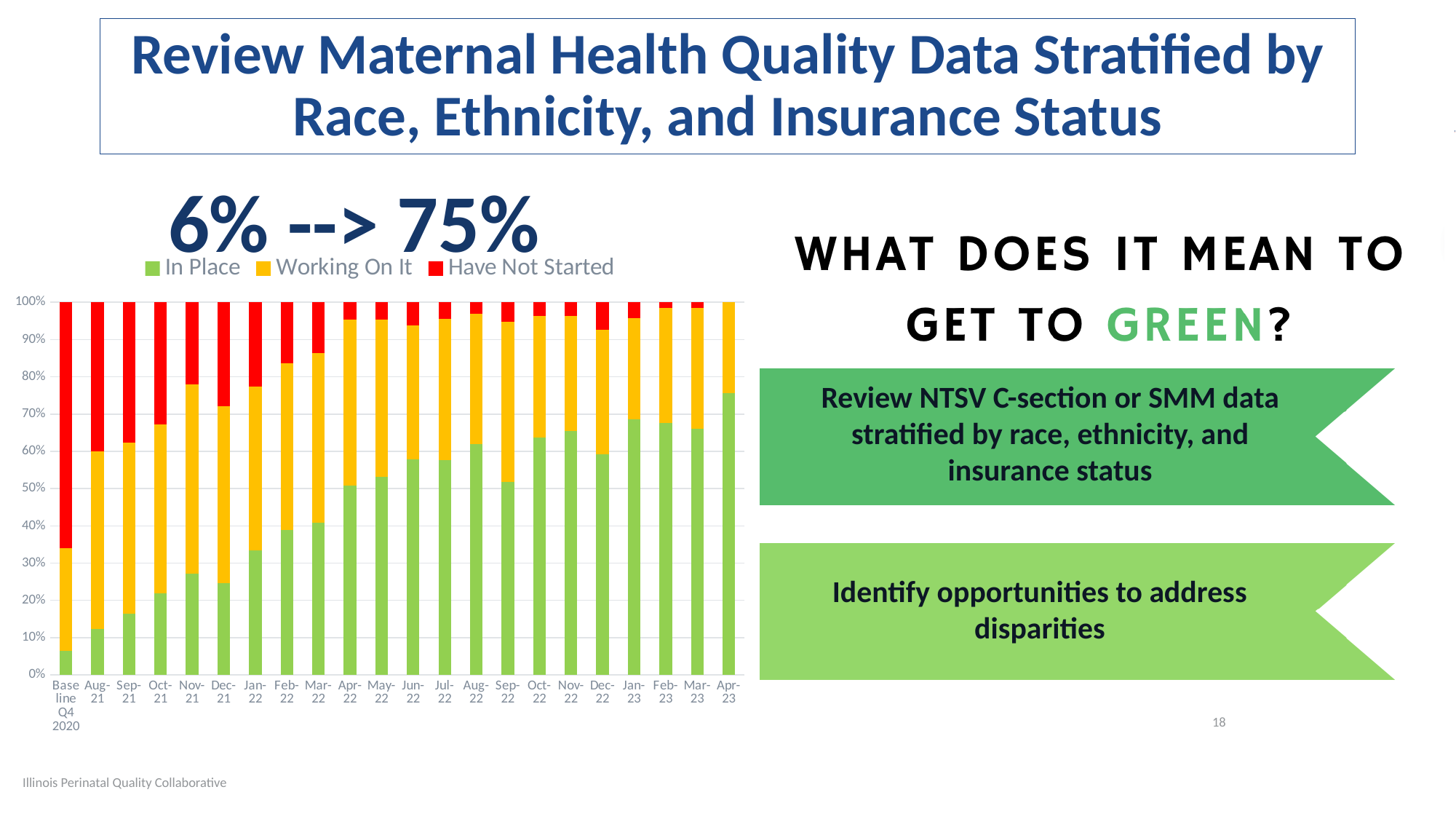
Is the 'In Place' value for Baseline Q4 2020 greater or less than 10%? less What change in the 'In Place' percentage does the headline above the chart state? 6% --> 75% Which period has the highest 'In Place' value? Apr-23 Which colour represents the 'Have Not Started' series in the chart? Red Is the 'In Place' value for Apr-23 greater or less than 70%? greater How many series does the chart legend list? 3 Which is larger, the 'Have Not Started' share in Aug-21 or in Apr-22? Aug-21 Is the 'Have Not Started' share for Baseline Q4 2020 greater or less than 60%? greater How many time periods (categories) are plotted along the x axis of the chart? 22 Which period has the lowest 'In Place' value? Baseline Q4 2020 What kind of chart is shown on the slide? Stacked bar chart Does the 'In Place' series generally rise or fall from Baseline Q4 2020 to Apr-23? Rise